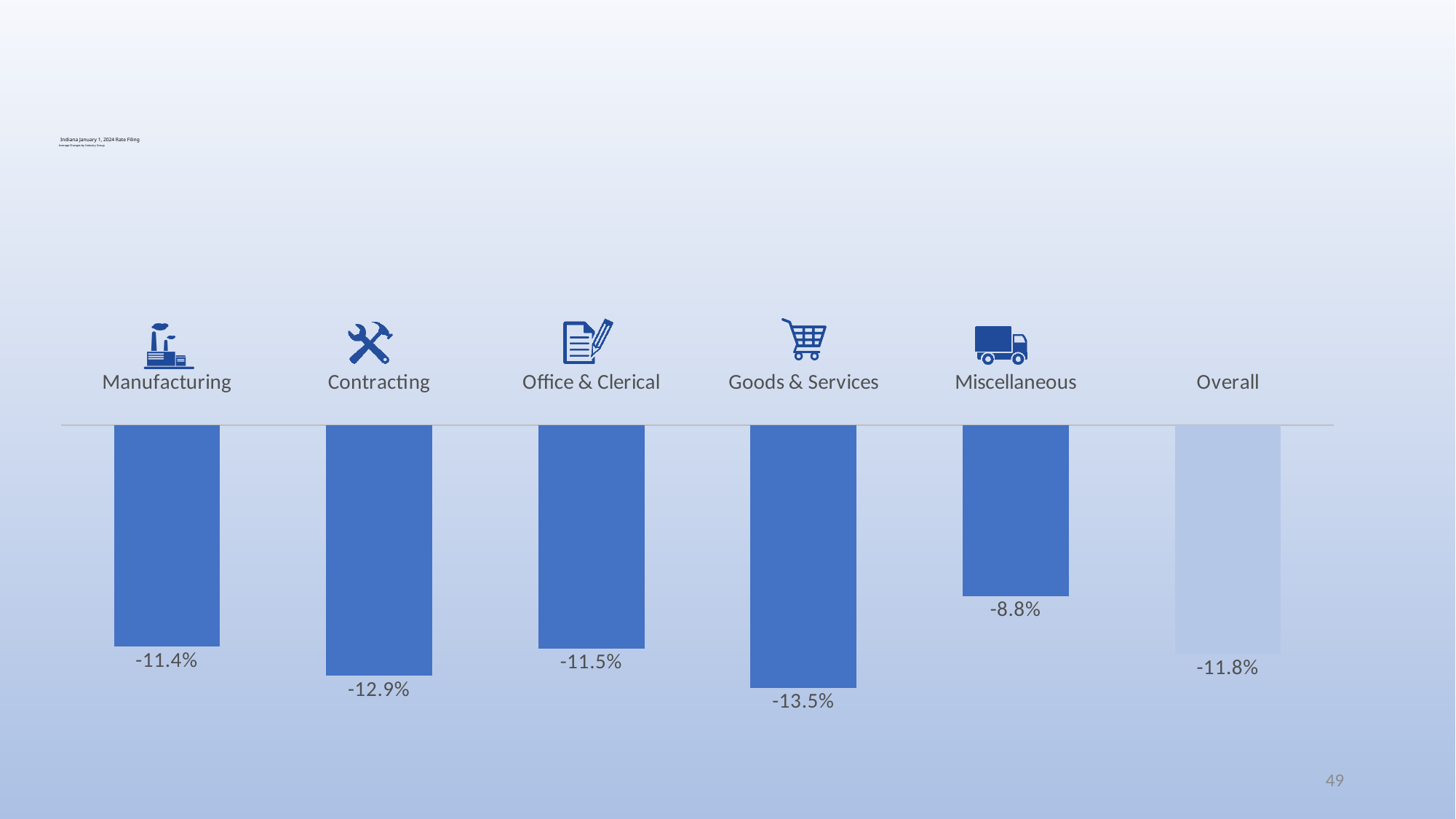
Which category shows the largest decrease (the most negative value)? Goods & Services Which category shows the smallest decrease (the least negative value)? Miscellaneous Which bar is drawn in a lighter shade of blue than the others? Overall By how many percentage points does the Goods & Services decrease exceed the Miscellaneous decrease? 4.7 percentage points Which has the larger decrease, Contracting or Miscellaneous? Contracting What is the value shown for Goods & Services? -13.5% How many categories are shown in the chart? 6 What is the value shown for Manufacturing? -11.4% By how many percentage points does the Contracting decrease exceed the Manufacturing decrease? 1.5 percentage points What is the value shown for Contracting? -12.9% What kind of chart is shown on the slide? Bar chart What is the value shown for Overall? -11.8%